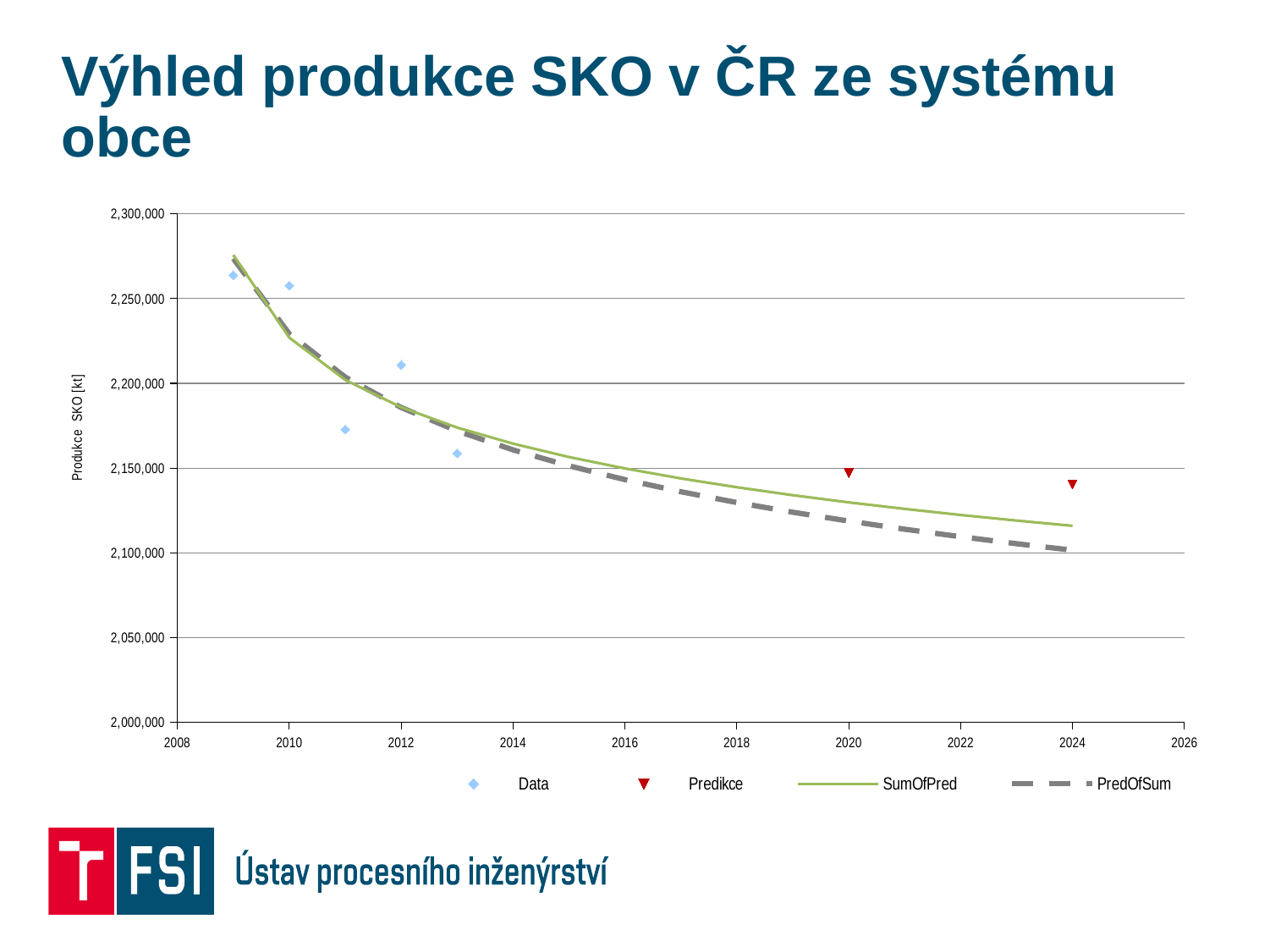
What is the label of the vertical axis? Produkce SKO [kt] Is the SumOfPred value at 2024 greater or less than 2,100,000? greater How many points are plotted for the Predikce series? 2 At 2024, which is higher: the SumOfPred line or the PredOfSum line? SumOfPred Which year has the lowest Data point? 2013 Which legend entry is drawn as a grey dashed line? PredOfSum How many points are plotted for the Data series? 5 Is the Data value for 2009 greater or less than 2,250,000? greater Does the SumOfPred line rise or fall from 2009 to 2024? fall Is the Predikce value for 2024 greater or less than 2,150,000? less How many series does the chart legend list? 4